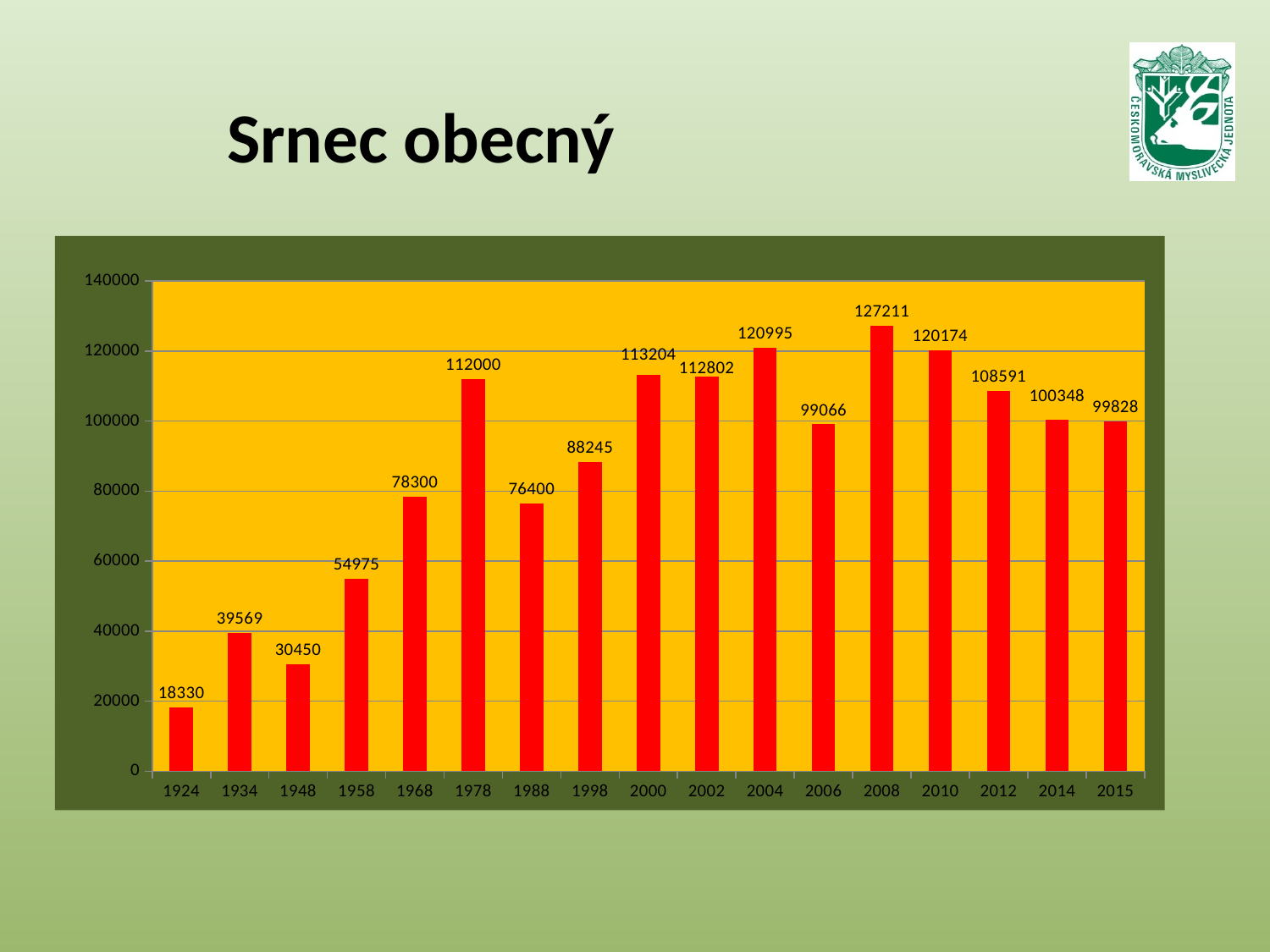
How many years are shown on the x axis? 17 What is the value for 2006? 99066 Which is larger, the value for 1934 or the value for 1948? 1934 Which year has the lowest value? 1924 What is the value for 1978? 112000 Do the values generally rise or fall from 1924 to 1978? rise What is the difference between the values for 2008 and 2010? 7037 What is the difference between the values for 1978 and 1988? 35600 Is the value for 1998 greater or less than 100000? less Which year has the highest value? 2008 What kind of chart is shown on the slide? bar chart What is the value for 1924? 18330